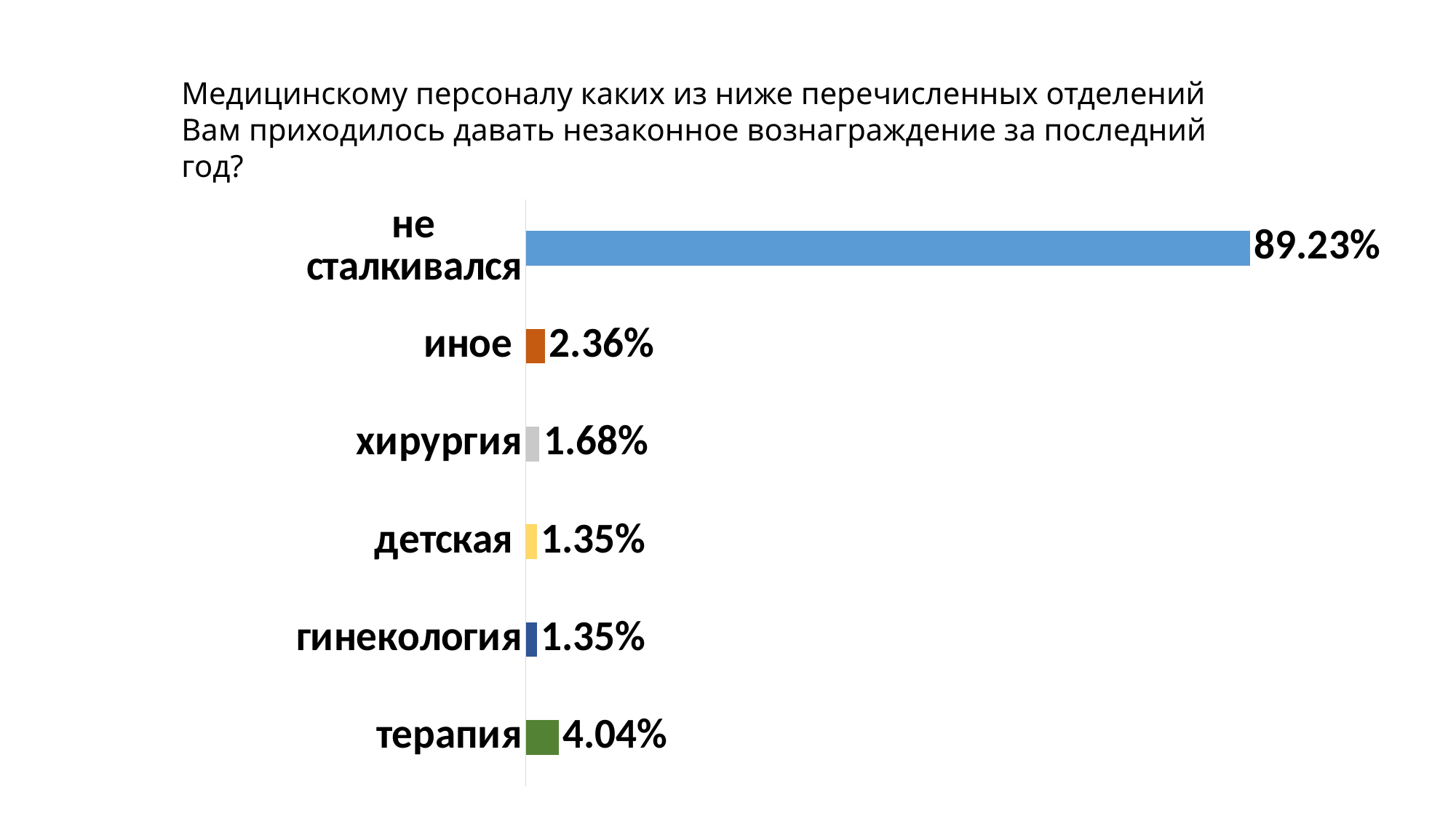
What colour is the bar for терапия? green Which is larger, the value for хирургия or the value for гинекология? хирургия Which category has the highest value? не сталкивался What kind of chart is shown on the slide? bar chart What is the value for иное? 2.36% What is the value for хирургия? 1.68% What is the value for терапия? 4.04% What is the difference between the values for иное and детская? 1.01% What is the value for не сталкивался? 89.23% What is the difference between the values for терапия and хирургия? 2.36% How many categories are shown in the chart? 6 Which is larger, the value for терапия or the value for иное? терапия